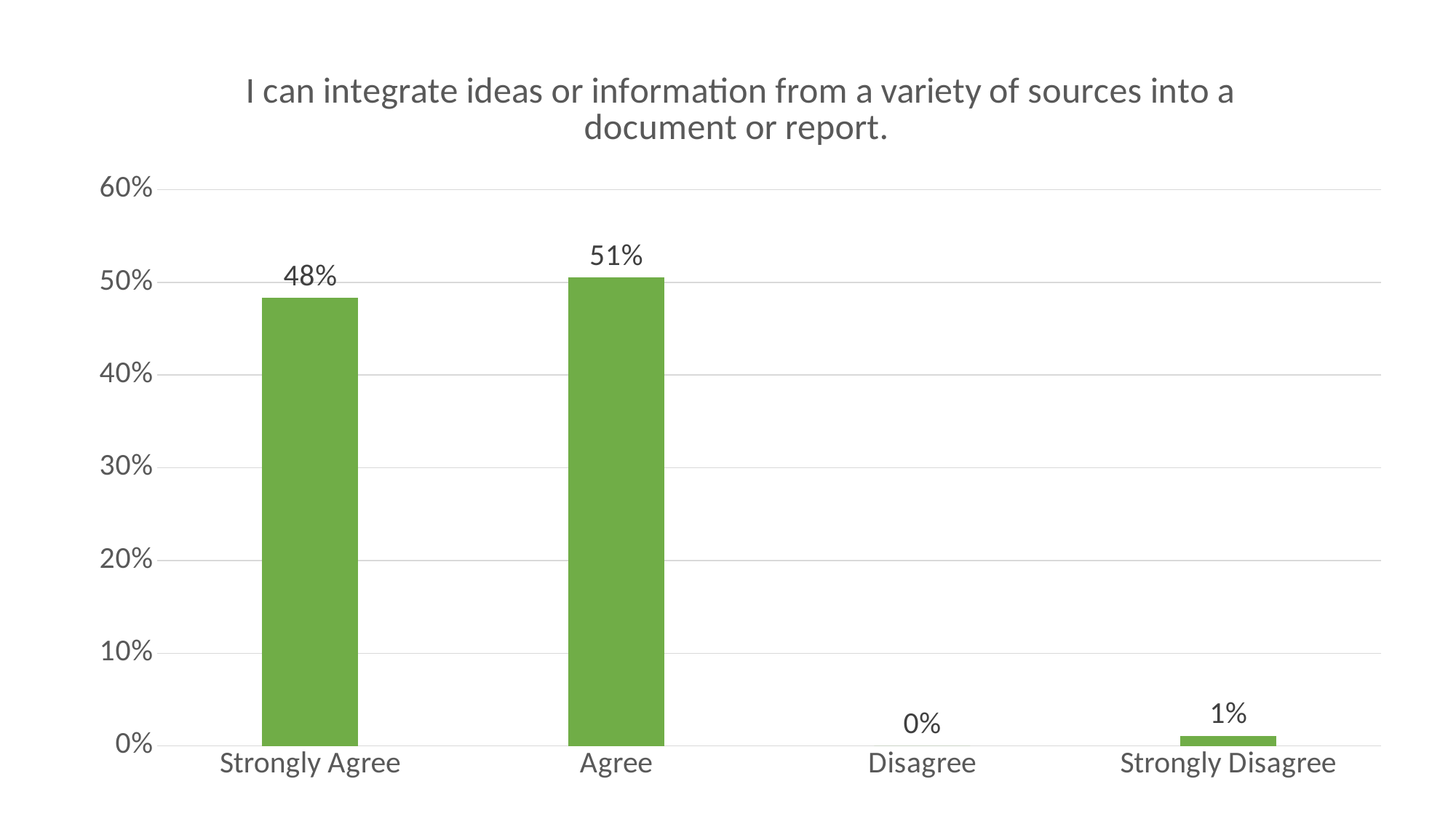
What percentage of respondents chose Disagree? 0% What percentage of respondents chose Strongly Disagree? 1% How many response categories are shown on the x axis? 4 What percentage of respondents chose Strongly Agree? 48% What is the difference in percentage points between Agree and Strongly Agree? 3% What percentage of respondents chose Agree? 51% What is the title of the chart? I can integrate ideas or information from a variety of sources into a document or report. Which is larger, the value for Strongly Agree or the value for Strongly Disagree? Strongly Agree What kind of chart is shown on the slide? Bar chart Which response category has the lowest percentage? Disagree Which response category has the highest percentage? Agree Is the value for Agree greater or less than 50%? greater